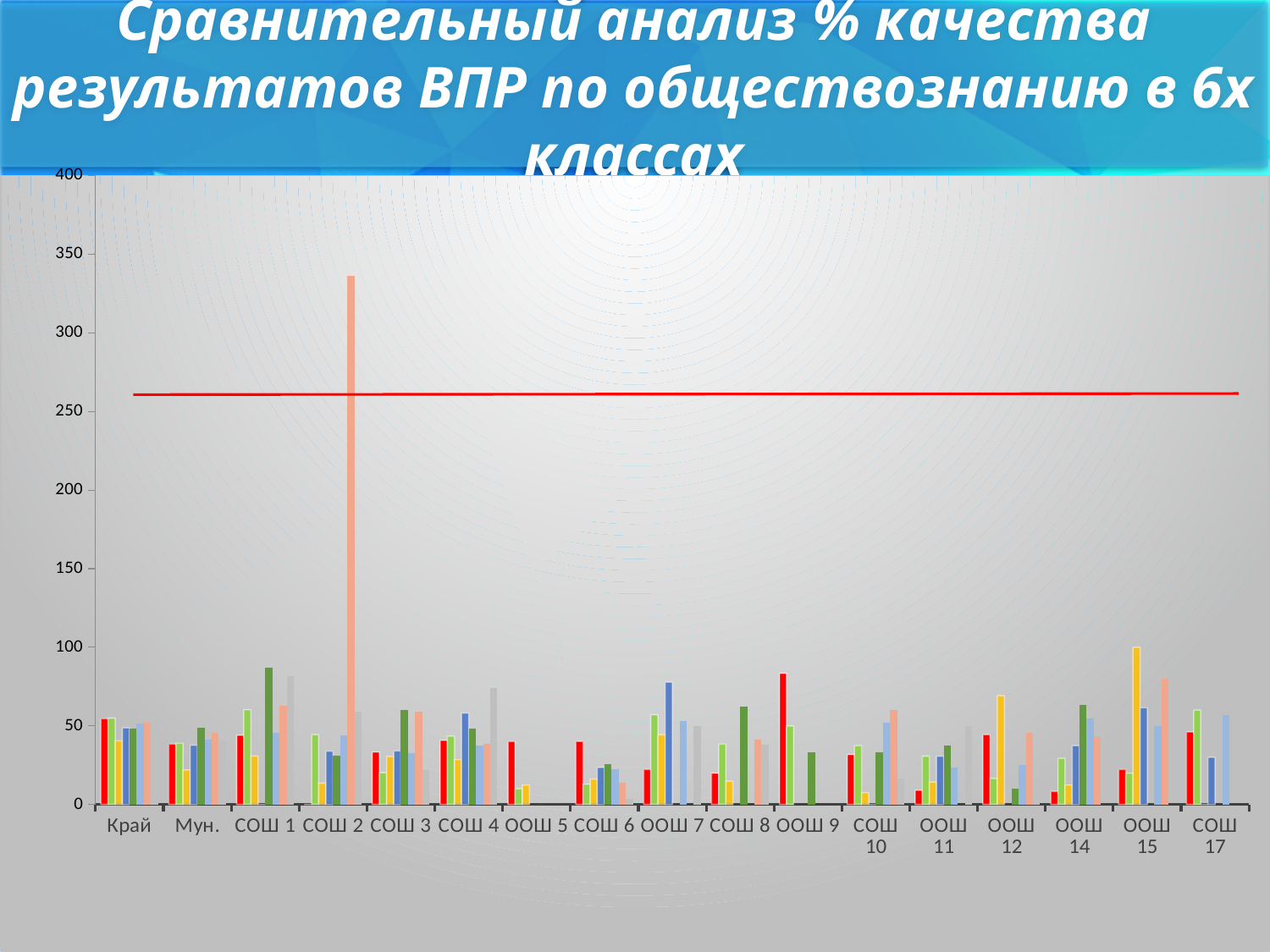
What kind of chart is shown on the slide? bar chart Is the tallest bar in the ООШ 5 group greater or less than 50? less What is the title of the slide above the chart? Сравнительный анализ % качества результатов ВПР по обществознанию в 6х классах Which group has the taller maximum bar, СОШ 1 or СОШ 2? СОШ 2 Is the tallest bar in the СОШ 2 group greater or less than 300? greater Is the tallest bar in the ООШ 15 group greater or less than 50? greater What is the highest value labelled on the y axis of the chart? 400 How many categories are shown along the x axis of the chart? 17 Which category contains the tallest bar in the chart? СОШ 2